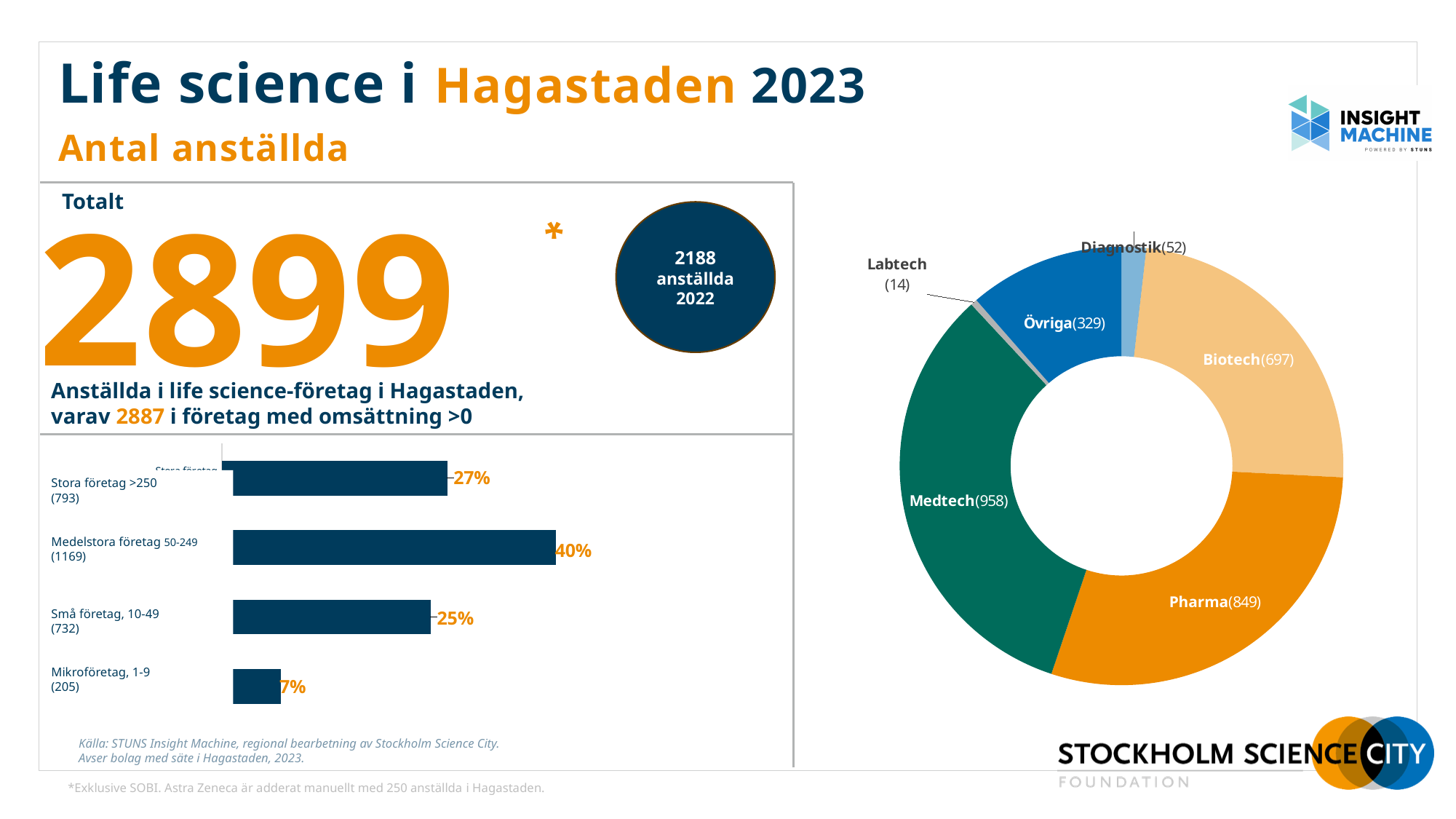
In the bar chart on the left, what percentage is shown for Medelstora företag 50-249? 40% In the donut chart on the right, which sector has the largest number of employees? Medtech How many sectors are labelled in the donut chart on the right? 6 What type of chart is used on the left side of the slide to show company size categories? Bar chart In the bar chart on the left, which company size category has the lowest percentage? Mikroföretag, 1-9 In the bar chart on the left, which company size category has the highest percentage? Medelstora företag 50-249 In the donut chart on the right, how many employees are shown for Labtech? 14 In the donut chart on the right, how many employees are shown for Medtech? 958 How many company size categories are shown in the bar chart on the left? 4 In the bar chart on the left, what percentage is shown for Mikroföretag, 1-9? 7% In the bar chart on the left, what is the difference in percentage points between Stora företag >250 and Små företag, 10-49? 2 In the donut chart on the right, what is the difference in employees between Pharma and Biotech? 152